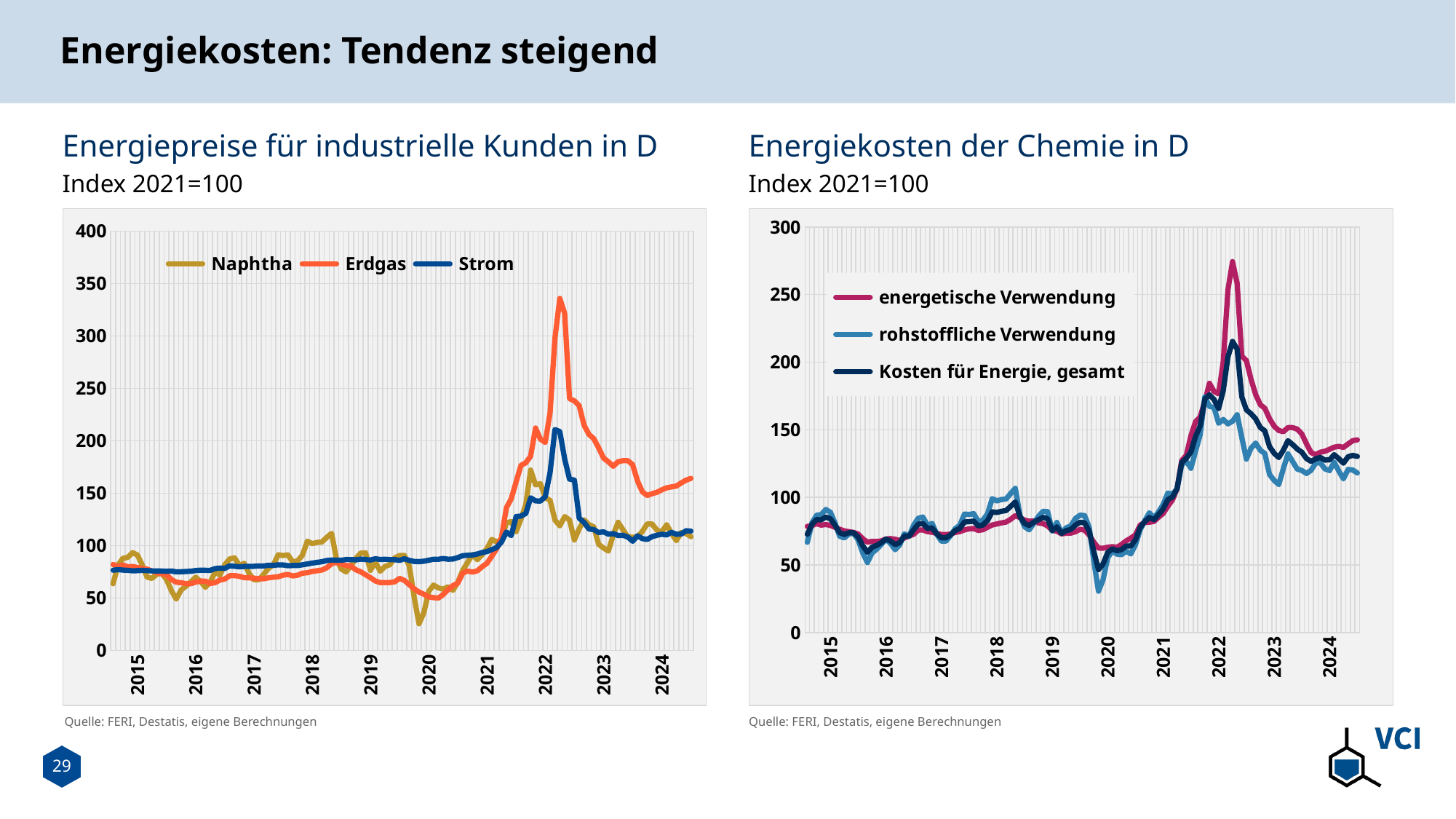
In the right chart 'Energiekosten der Chemie in D', which series reaches the highest peak? energetische Verwendung In the left chart 'Energiepreise für industrielle Kunden in D', is the peak value of Erdgas in 2022 greater or less than 300? greater How many series does the legend of the left chart 'Energiepreise für industrielle Kunden in D' list? 3 How many series does the legend of the right chart 'Energiekosten der Chemie in D' list? 3 In the left chart 'Energiepreise für industrielle Kunden in D', is the peak value of Strom in 2022 greater or less than 200? greater In the left chart 'Energiepreise für industrielle Kunden in D', which series reaches the highest peak? Erdgas In the right chart 'Energiekosten der Chemie in D', at the 2022 peak, which series is higher: 'energetische Verwendung' or 'rohstoffliche Verwendung'? energetische Verwendung What index base is stated under the titles of both charts? Index 2021=100 What kind of chart is the left chart, 'Energiepreise für industrielle Kunden in D'? line chart In the right chart 'Energiekosten der Chemie in D', is the peak value of 'energetische Verwendung' in 2022 greater or less than 250? greater What kind of chart is the right chart, 'Energiekosten der Chemie in D'? line chart